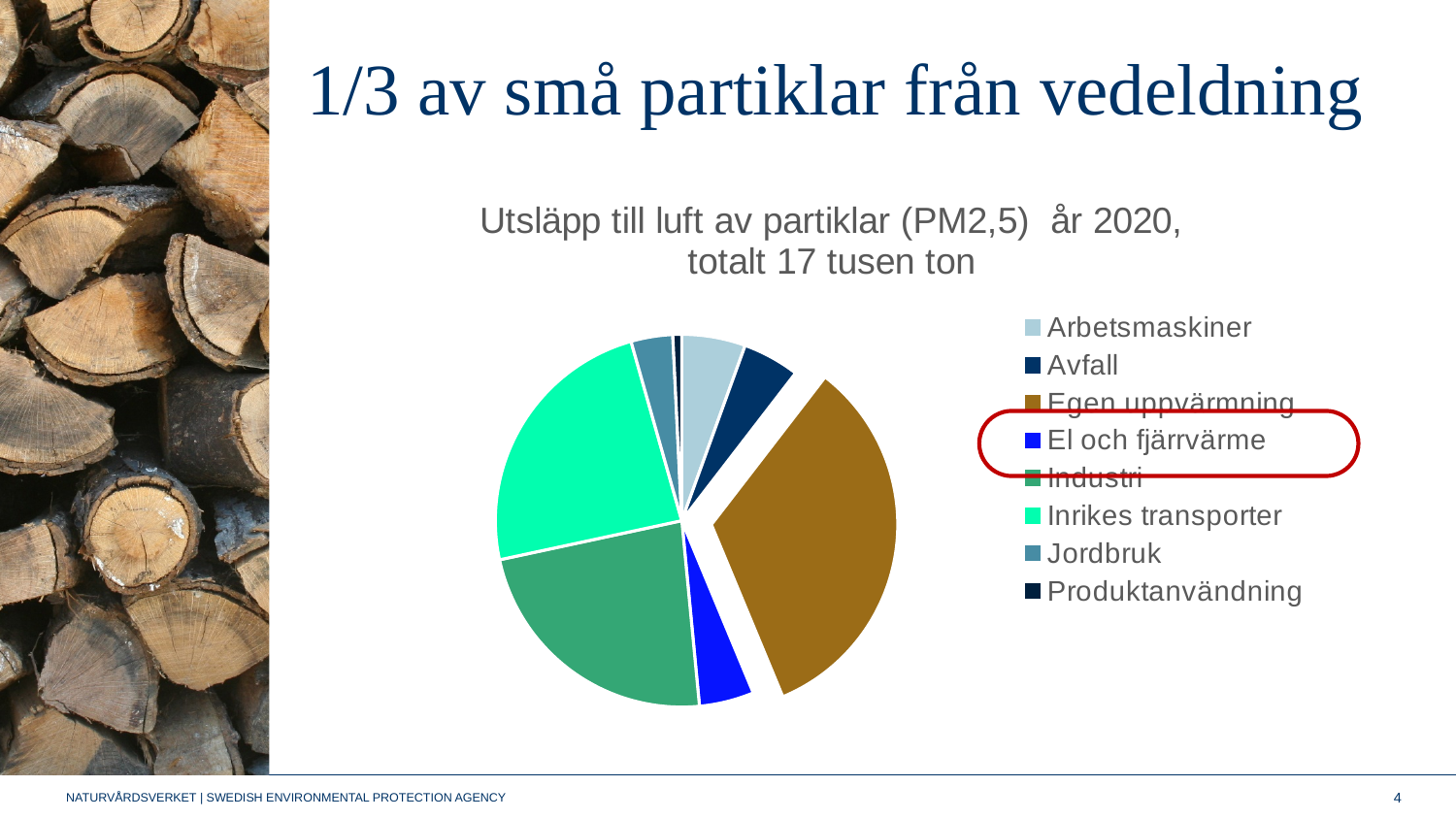
Which slice is larger, Egen uppvärmning or El och fjärrvärme? Egen uppvärmning What total amount of PM2,5 emissions for 2020 is stated in the chart title? 17 tusen ton What kind of chart is shown on the slide? pie chart How many categories does the pie chart's legend list? 8 Which slice is larger, Industri or El och fjärrvärme? Industri Which slice is larger, Jordbruk or Produktanvändning? Jordbruk Which category has the smallest slice of the pie chart? Produktanvändning Which legend entry is circled in red? El och fjärrvärme Which category has the largest slice of the pie chart? Egen uppvärmning